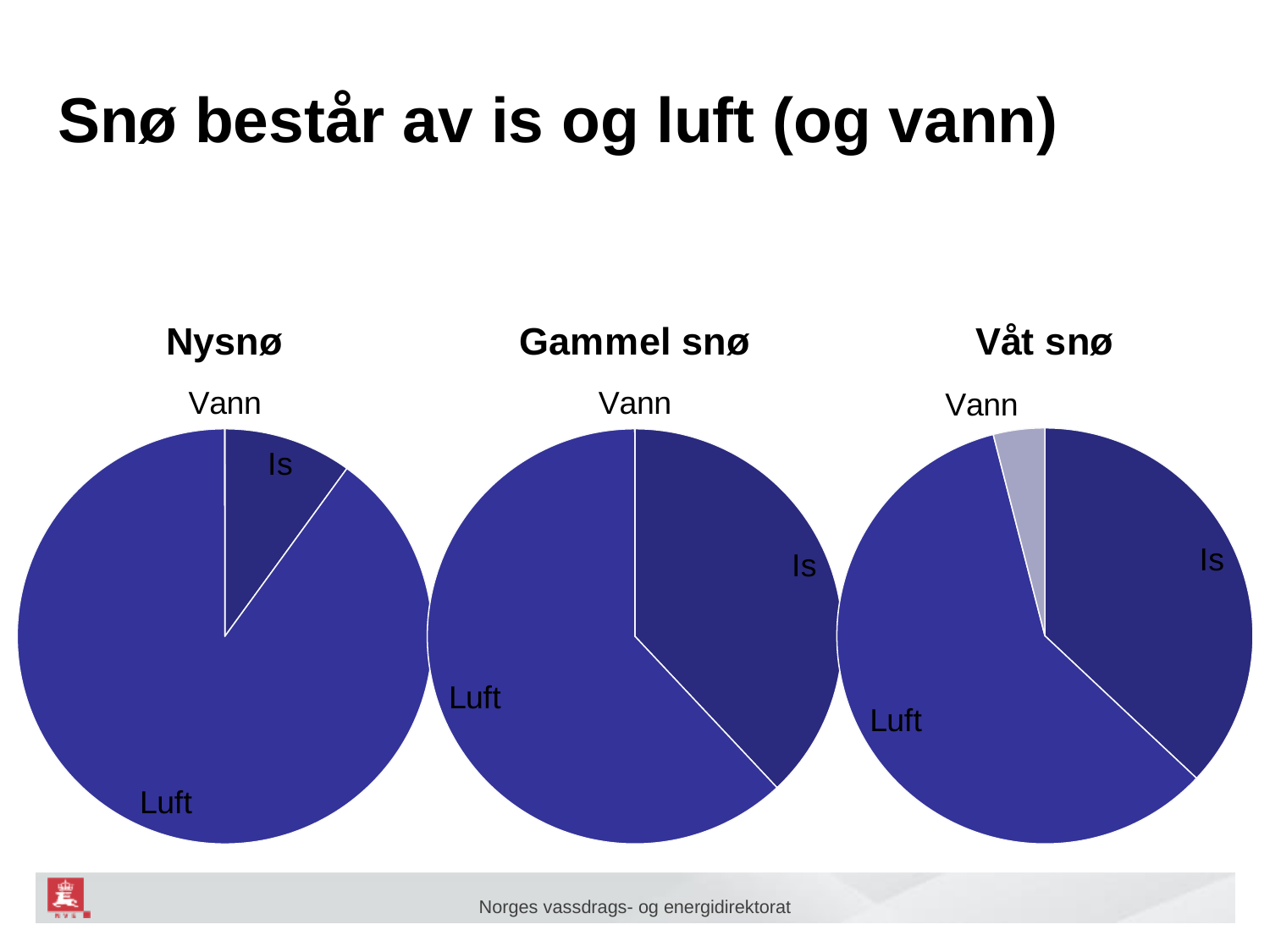
In the "Gammel snø" pie chart, which slice is the largest? Luft What kind of chart is used for "Nysnø"? pie chart In the "Nysnø" pie chart, which slice is the largest? Luft In the "Våt snø" pie chart, which slice is the smallest? Vann In the "Våt snø" pie chart, which is larger, Is or Vann? Is In the "Gammel snø" pie chart, which is larger, Luft or Is? Luft What is the title of the pie chart in the middle of the slide? Gammel snø What is the title of the pie chart on the right of the slide? Våt snø How many pie charts are shown on the slide? 3 How many slices are labelled in the "Våt snø" pie chart? 3 In the "Nysnø" pie chart, which is larger, Luft or Is? Luft